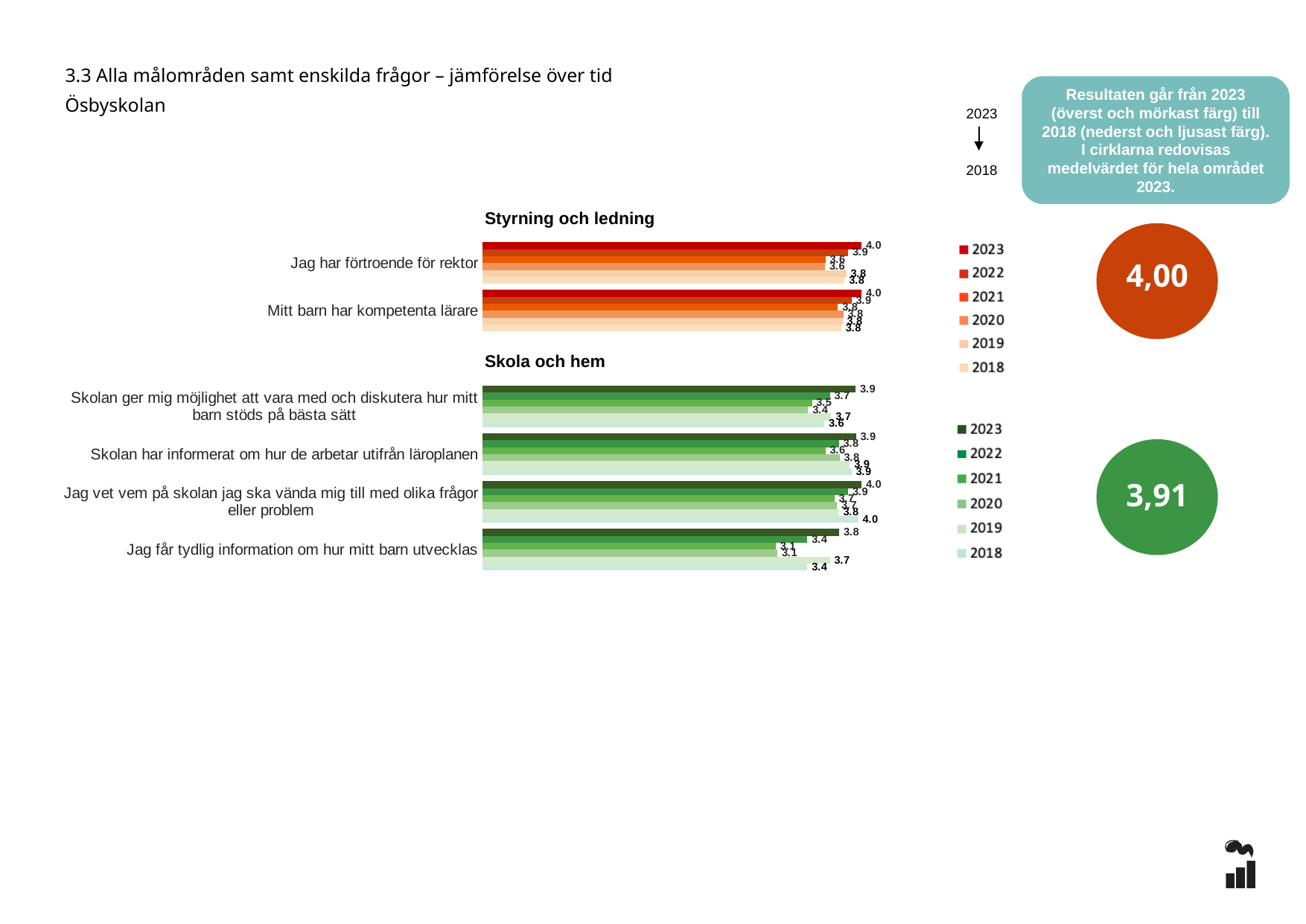
How many series does the legend of the 'Skola och hem' chart list? 6 In the 'Styrning och ledning' chart, what is the 2022 value for 'Mitt barn har kompetenta lärare'? 3.9 In the 'Skola och hem' chart, which question has the lowest 2023 value? Jag får tydlig information om hur mitt barn utvecklas In the 'Skola och hem' chart, what is the 2022 value for 'Jag får tydlig information om hur mitt barn utvecklas'? 3.4 How many questions (categories) are shown in the 'Skola och hem' chart? 4 In the 'Skola och hem' chart, what is the 2018 value for 'Jag vet vem på skolan jag ska vända mig till med olika frågor eller problem'? 4.0 In the 'Skola och hem' chart, what is the 2023 value for 'Jag får tydlig information om hur mitt barn utvecklas'? 3.8 What mean value is shown in the green circle next to the 'Skola och hem' chart? 3,91 In the 'Skola och hem' chart, what is the difference between the 2023 and 2022 values for 'Jag får tydlig information om hur mitt barn utvecklas'? 0.4 In the 'Styrning och ledning' chart, what is the 2023 value for 'Jag har förtroende för rektor'? 4.0 In the 'Skola och hem' chart, which is larger for 'Skolan ger mig möjlighet att vara med och diskutera hur mitt barn stöds på bästa sätt': the 2023 value or the 2022 value? 2023 What kind of chart is the 'Styrning och ledning' chart? Bar chart